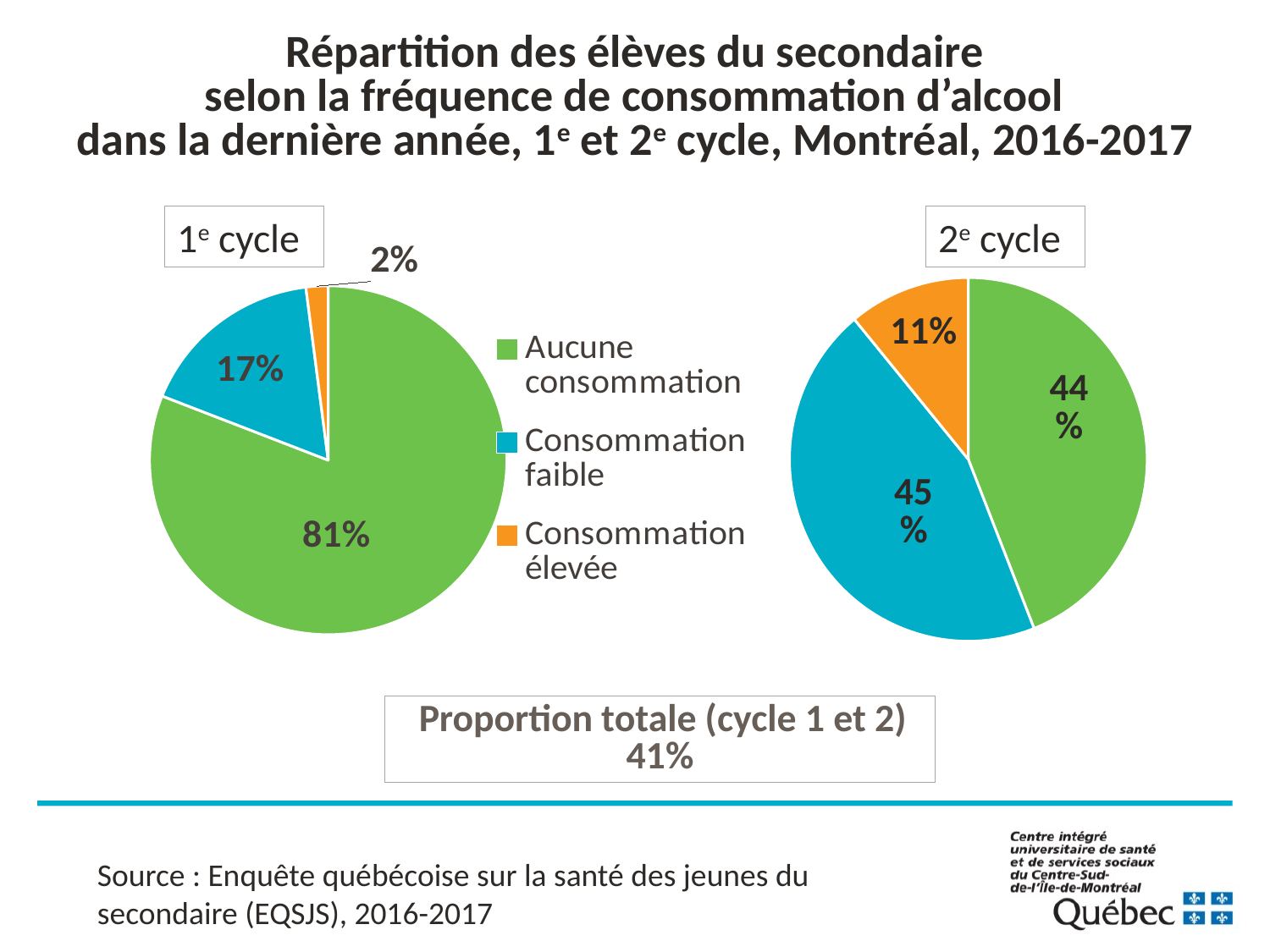
In the 2e cycle pie chart, what percentage of students had no alcohol consumption (Aucune consommation)? 44% In the 1e cycle pie chart, which category has the largest share? Aucune consommation Which is larger: the Consommation faible share in the 1e cycle chart or in the 2e cycle chart? 2e cycle How many categories does the legend list? 3 In the 2e cycle pie chart, which category has the smallest share? Consommation élevée In the 1e cycle pie chart, what percentage of students had high consumption (Consommation élevée)? 2% In the 2e cycle pie chart, what percentage of students had low consumption (Consommation faible)? 45% In the 1e cycle pie chart, what percentage of students had low consumption (Consommation faible)? 17% What type of chart is used on this slide? Pie chart In the 2e cycle pie chart, what percentage of students had high consumption (Consommation élevée)? 11% What is the difference between the Consommation élevée share in the 2e cycle chart and in the 1e cycle chart? 9 percentage points In the 1e cycle pie chart, what percentage of students had no alcohol consumption (Aucune consommation)? 81%